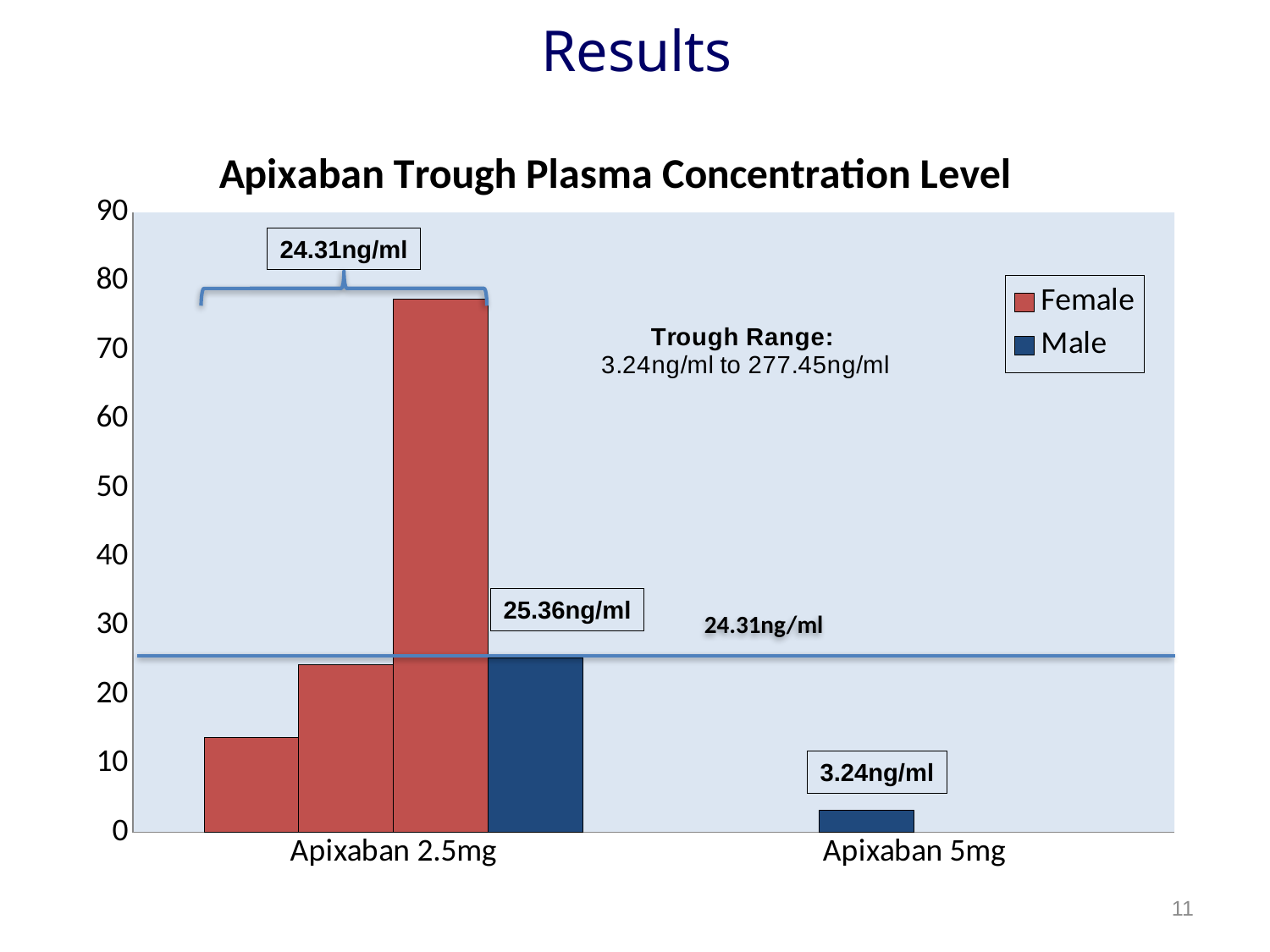
How many series does the legend list? 2 What value is labelled on the horizontal line drawn across the chart? 24.31ng/ml What is the difference between the Male trough concentrations for Apixaban 2.5mg and Apixaban 5mg? 22.12ng/ml What trough range is stated on the chart? 3.24ng/ml to 277.45ng/ml Which dose group has the higher Male trough concentration, Apixaban 2.5mg or Apixaban 5mg? Apixaban 2.5mg Is the shortest Female bar in the Apixaban 2.5mg group greater or less than 20? less What is the labelled trough concentration for the Male bar in the Apixaban 2.5mg group? 25.36ng/ml What kind of chart is shown on the slide? bar chart What is the labelled trough concentration for the Male bar in the Apixaban 5mg group? 3.24ng/ml How many dose categories are shown on the x axis? 2 Is the tallest Female bar in the Apixaban 2.5mg group greater or less than 70? greater Which series contains the tallest bar on the chart? Female